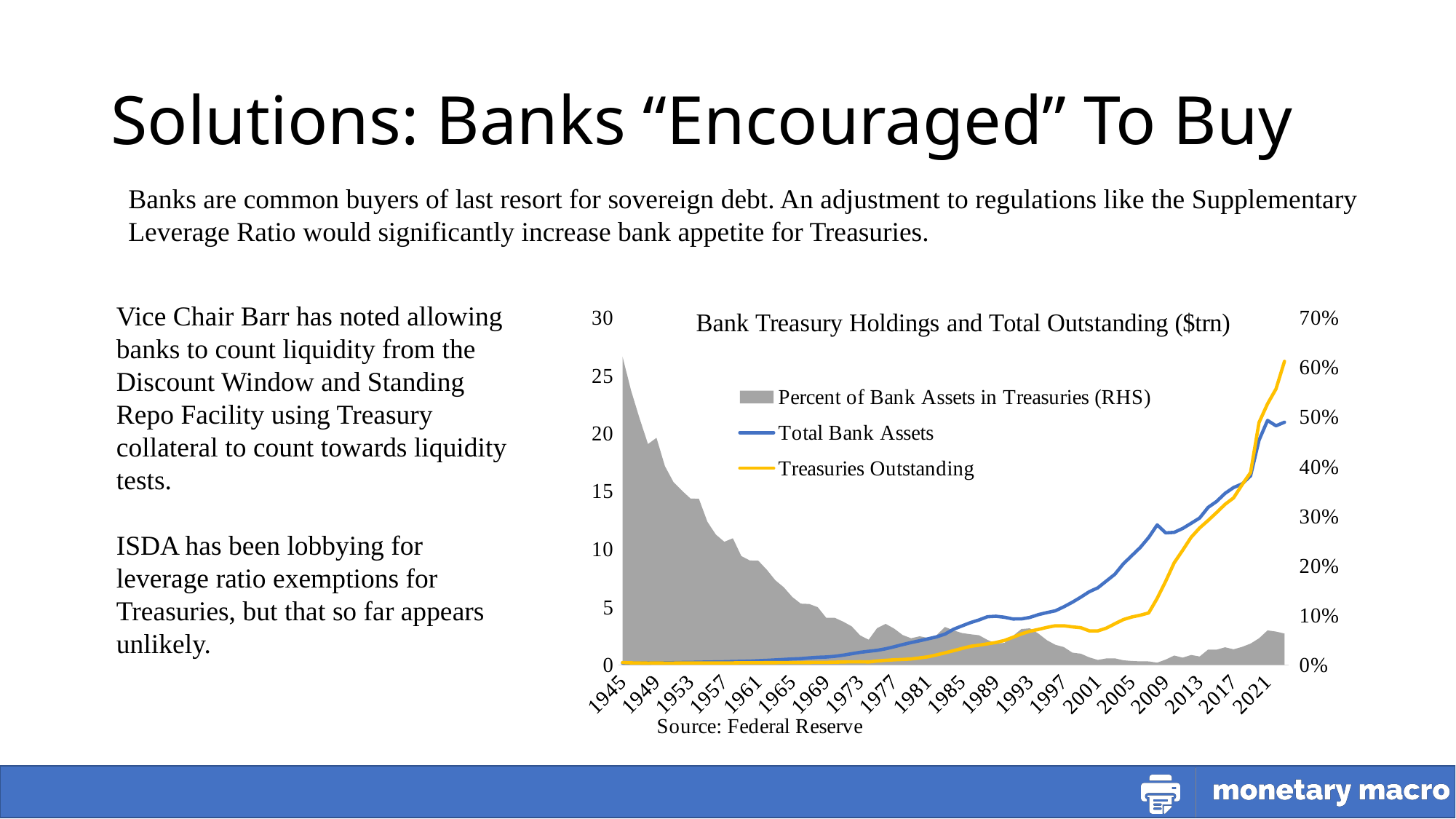
Does the Percent of Bank Assets in Treasuries rise or fall between 1945 and 1965? fall Which series in the chart is plotted against the right-hand axis? Percent of Bank Assets in Treasuries (RHS) How many series does the chart's legend list? 3 What is the title of the chart? Bank Treasury Holdings and Total Outstanding ($trn) Is the Percent of Bank Assets in Treasuries in 2021 greater or less than 10%? less Is the value of Treasuries Outstanding in 2021 greater or less than 20? greater Is the value of Total Bank Assets in 2021 greater or less than 15? greater Does Treasuries Outstanding rise or fall between 2009 and 2021? rise In 2021, which is larger: Treasuries Outstanding or Total Bank Assets? Treasuries Outstanding